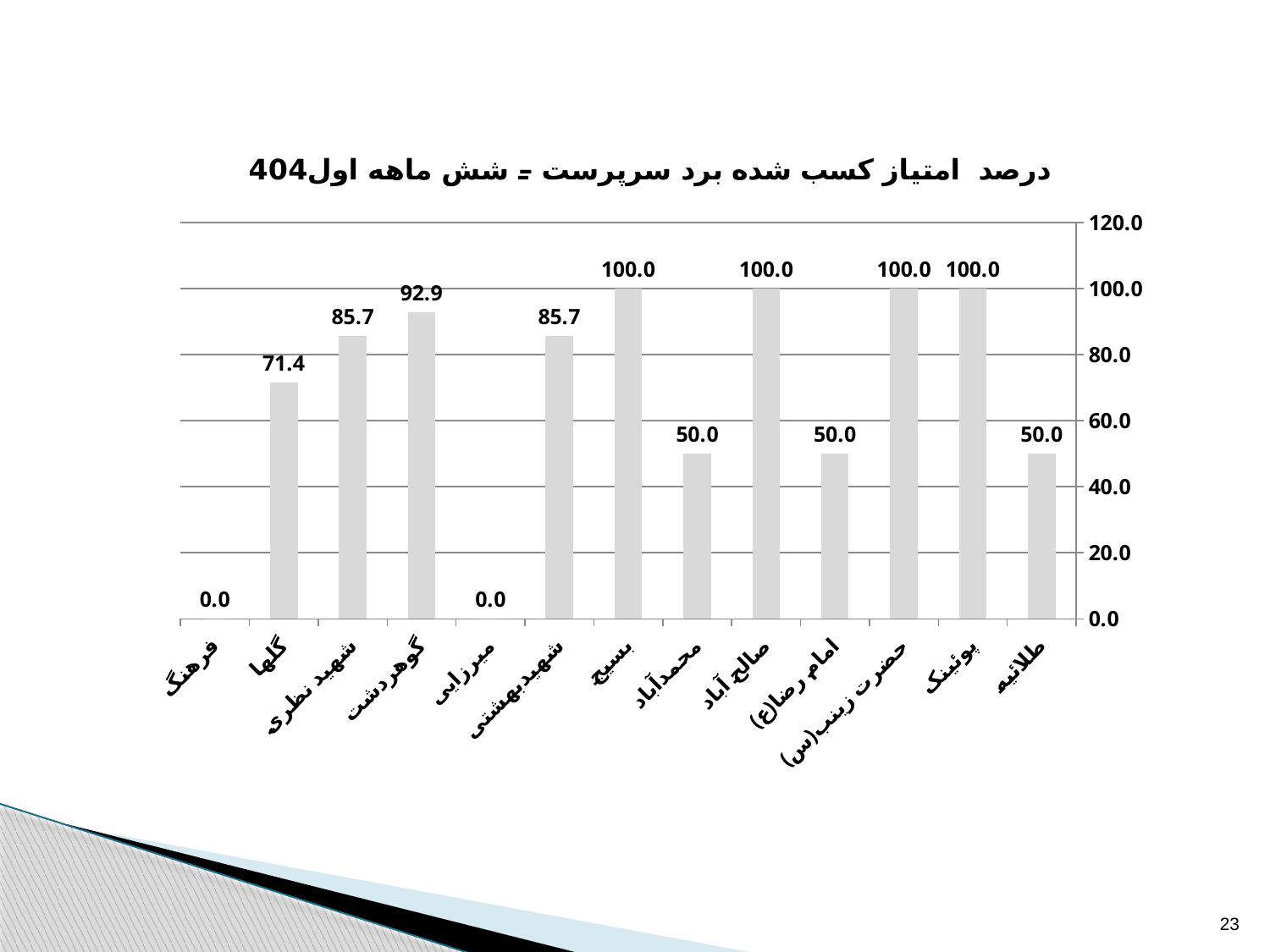
What is the value for گلها? 71.4 What is the value for میرزایی? 0.0 What is the difference between the values for گوهردشت and گلها? 21.5 What is the value for شهید نظری? 85.7 Is the value for گلها greater or less than 60.0? greater What is the value for گوهردشت? 92.9 Which is larger, the value for شهیدبهشتی or the value for طلائیه? شهیدبهشتی What is the highest value shown on the vertical axis? 120.0 How many categories have a value of 100.0? 4 What is the value for محمدآباد? 50.0 What kind of chart is shown on the slide? bar chart How many categories are shown on the x axis? 13